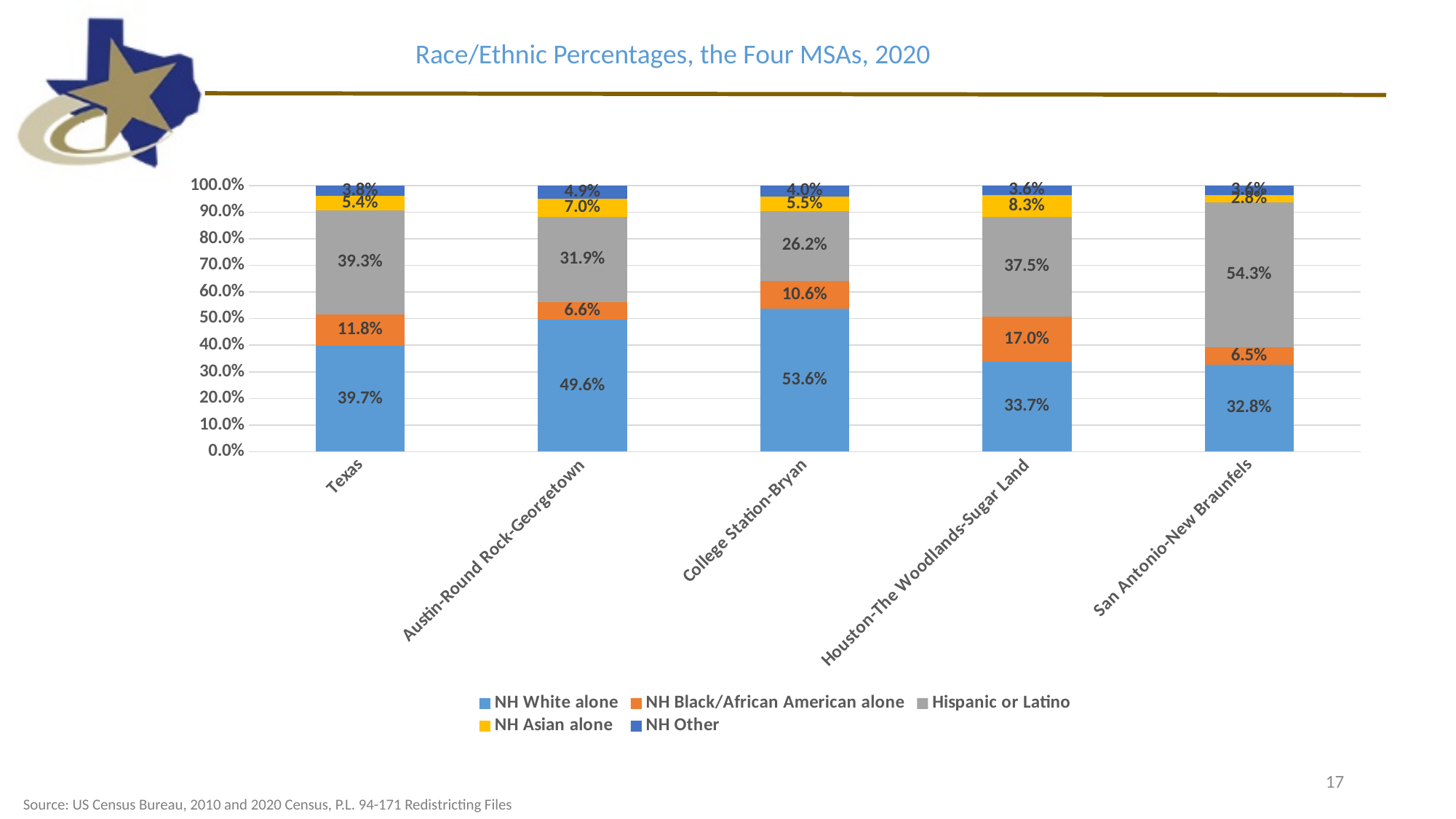
What is the title of the chart? Race/Ethnic Percentages, the Four MSAs, 2020 How many categories (MSAs and Texas) are shown on the x axis? 5 Which is larger: the Hispanic or Latino percentage for Texas or for Austin-Round Rock-Georgetown? Texas What is the NH Asian alone percentage for Texas? 5.4% Which category has the lowest NH Asian alone percentage? San Antonio-New Braunfels Which MSA has the highest NH White alone percentage? College Station-Bryan What is the Hispanic or Latino percentage for San Antonio-New Braunfels? 54.3% What kind of chart is shown on the slide? Stacked bar chart What is the NH Black/African American alone percentage for Houston-The Woodlands-Sugar Land? 17.0% What percentage of the population in College Station-Bryan is NH White alone? 53.6% What is the difference between the NH Black/African American alone percentages for Houston-The Woodlands-Sugar Land and Austin-Round Rock-Georgetown? 10.4 percentage points How many series does the legend list? 5